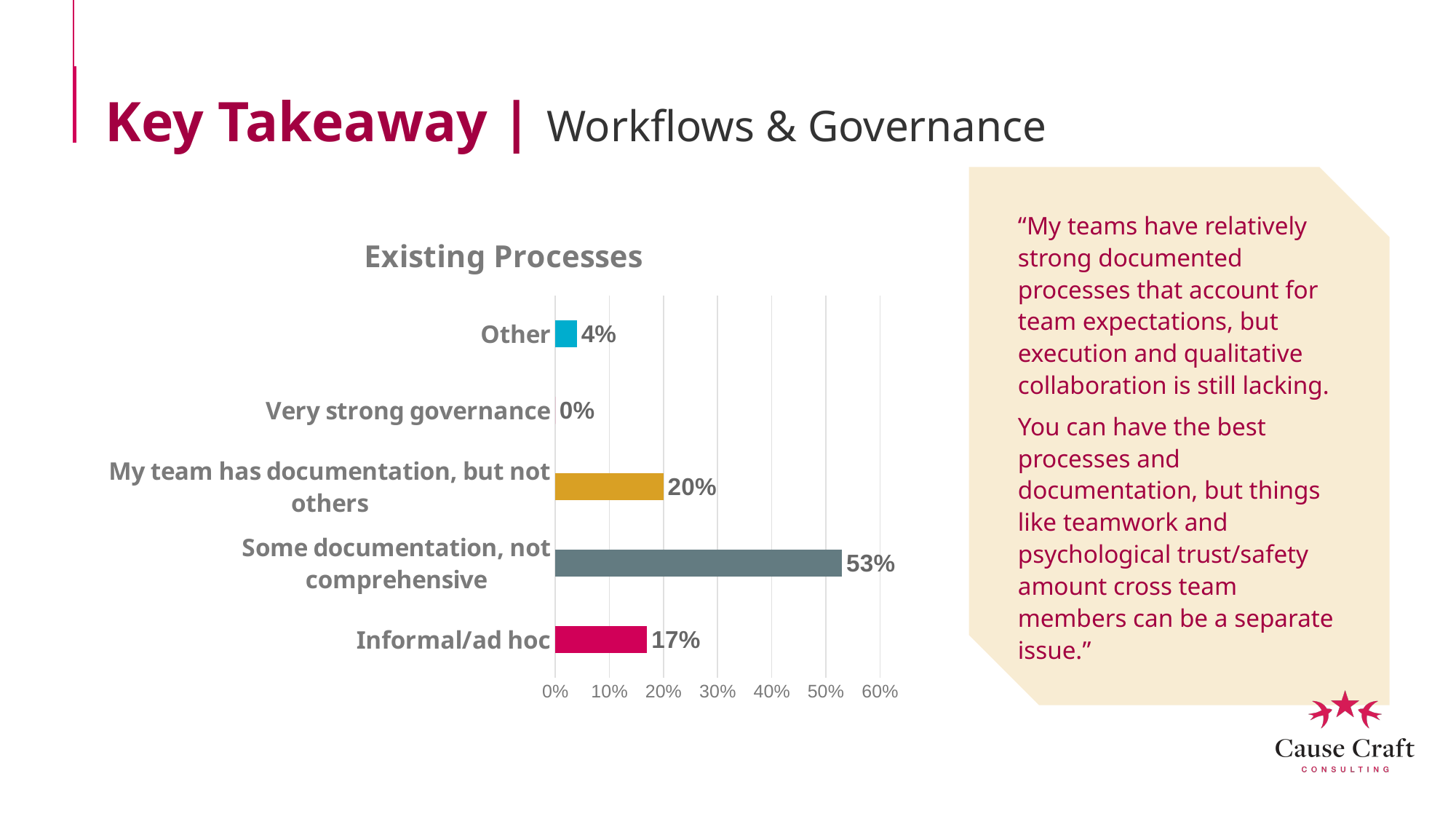
Which is larger, "Informal/ad hoc" or "Other"? Informal/ad hoc Which category has the lowest value? Very strong governance What is the value for "Very strong governance"? 0% Is the value for "Some documentation, not comprehensive" greater or less than 40%? greater What kind of chart is shown? bar chart How many categories are shown in the chart? 5 What is the value for "Some documentation, not comprehensive"? 53% What is the value for "Informal/ad hoc"? 17% What is the value for "My team has documentation, but not others"? 20% Which category has the highest value? Some documentation, not comprehensive What is the title of the chart? Existing Processes What is the difference between "Some documentation, not comprehensive" and "My team has documentation, but not others"? 33%